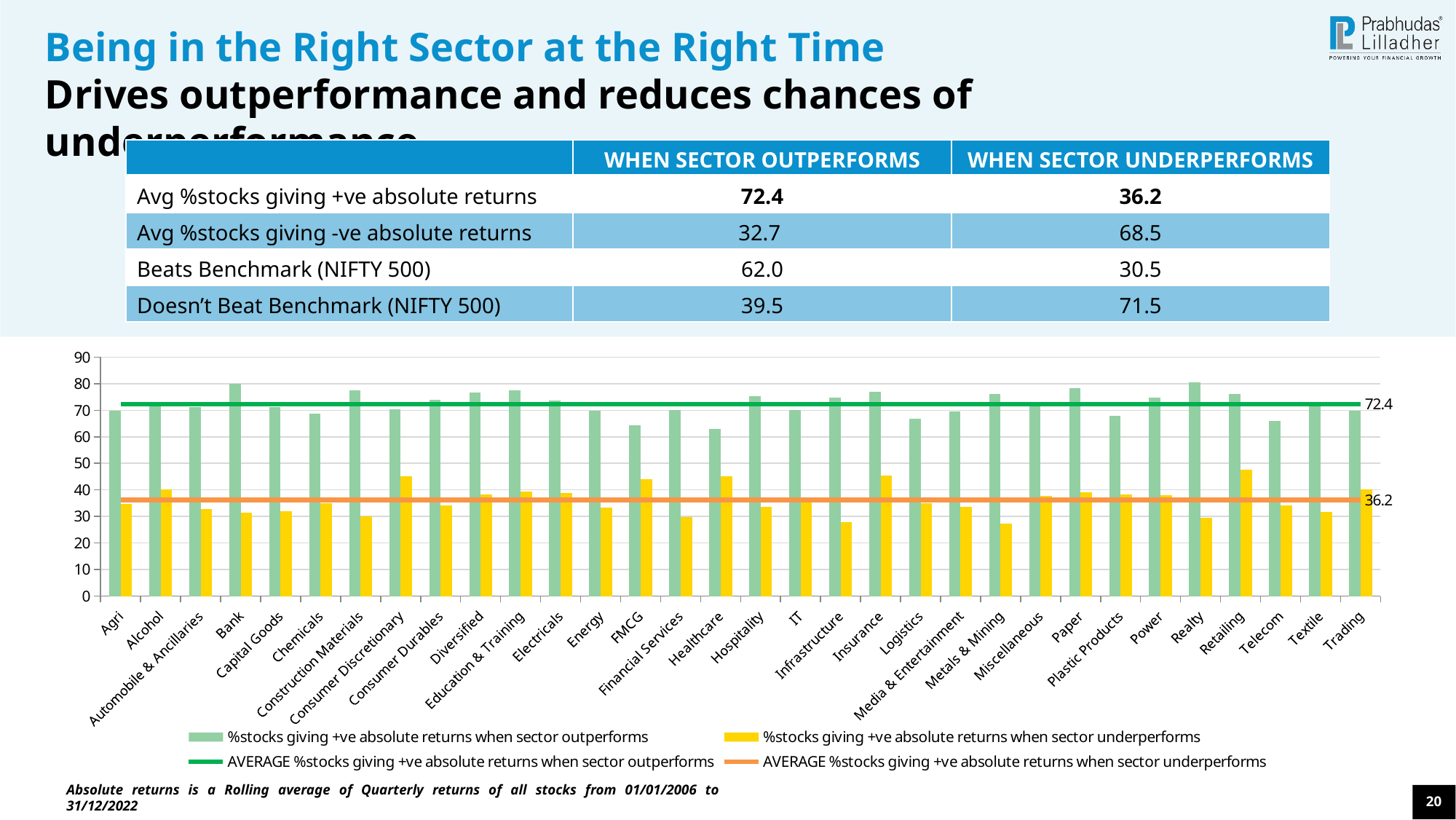
How many series does the chart legend list? 4 Is the value for Healthcare in the series '%stocks giving +ve absolute returns when sector outperforms' greater or less than 70? less Is the value for Retailing in the series '%stocks giving +ve absolute returns when sector underperforms' greater or less than 40? greater Is the value for Metals & Mining in the series '%stocks giving +ve absolute returns when sector underperforms' greater or less than 30? less What value is labelled on the orange average line for %stocks giving +ve absolute returns when sector underperforms? 36.2 What value is labelled on the green average line for %stocks giving +ve absolute returns when sector outperforms? 72.4 What is the difference between the two labelled average lines, 72.4 and 36.2? 36.2 Which has the larger value in the series '%stocks giving +ve absolute returns when sector outperforms': Bank or Healthcare? Bank What kind of chart is shown on the slide? Bar chart with average lines How many sectors are shown on the x axis of the chart? 32 Which colour represents '%stocks giving +ve absolute returns when sector underperforms' in the chart? Yellow